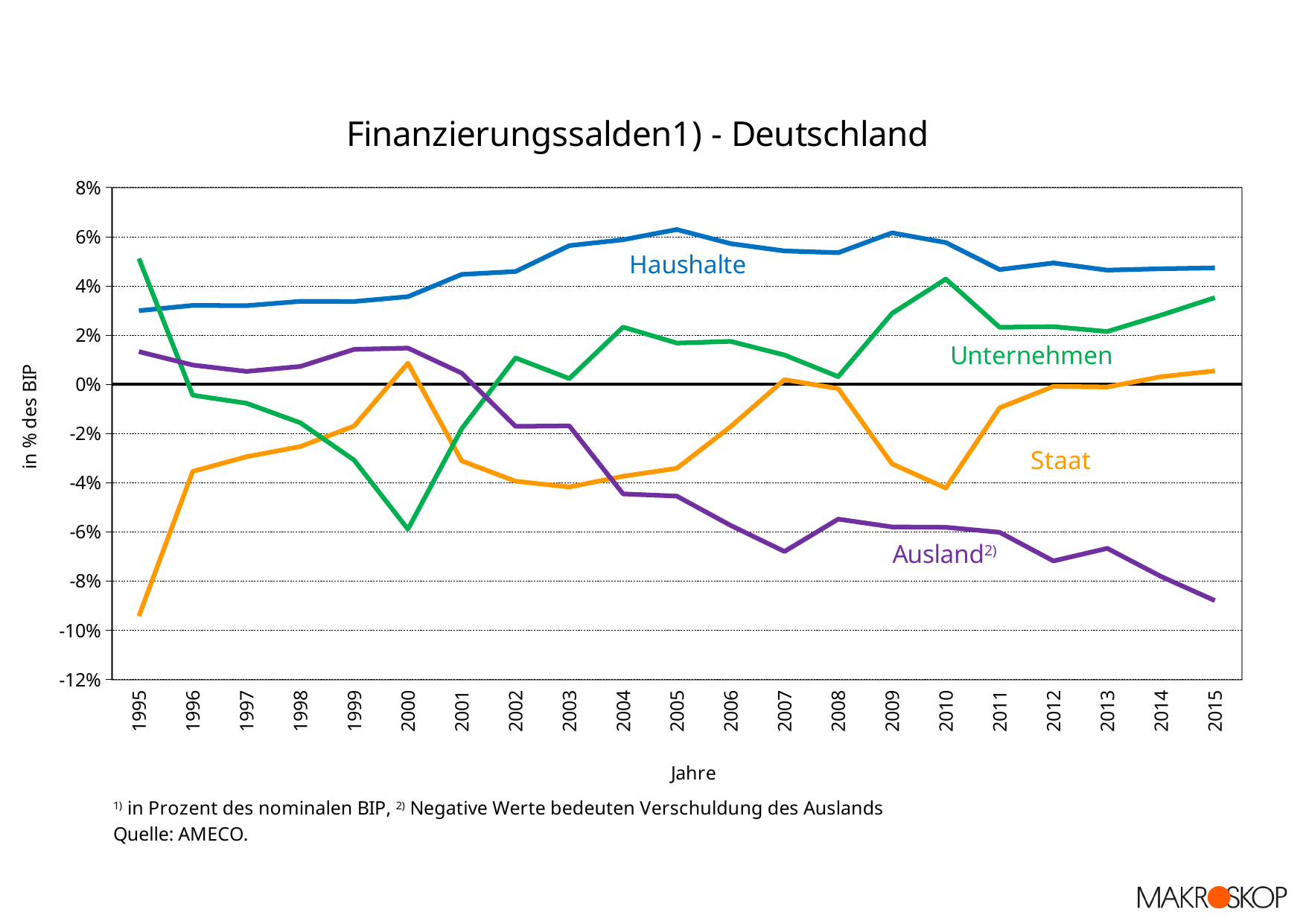
Is the value for Staat in 1995 greater or less than -8%? less In which year does Staat reach its lowest value? 1995 In 2015, which is higher: Haushalte or Unternehmen? Haushalte Which series has the highest value in 2005? Haushalte Is the value for Unternehmen in 2000 greater or less than -4%? less How many series are plotted in the chart? 4 Is the value for Haushalte in 2005 greater or less than 6%? greater What kind of chart is shown on the slide? line chart In which year does Unternehmen reach its lowest value? 2000 How many years are shown on the x axis? 21 Does the Ausland series rise or fall overall from 1995 to 2015? fall